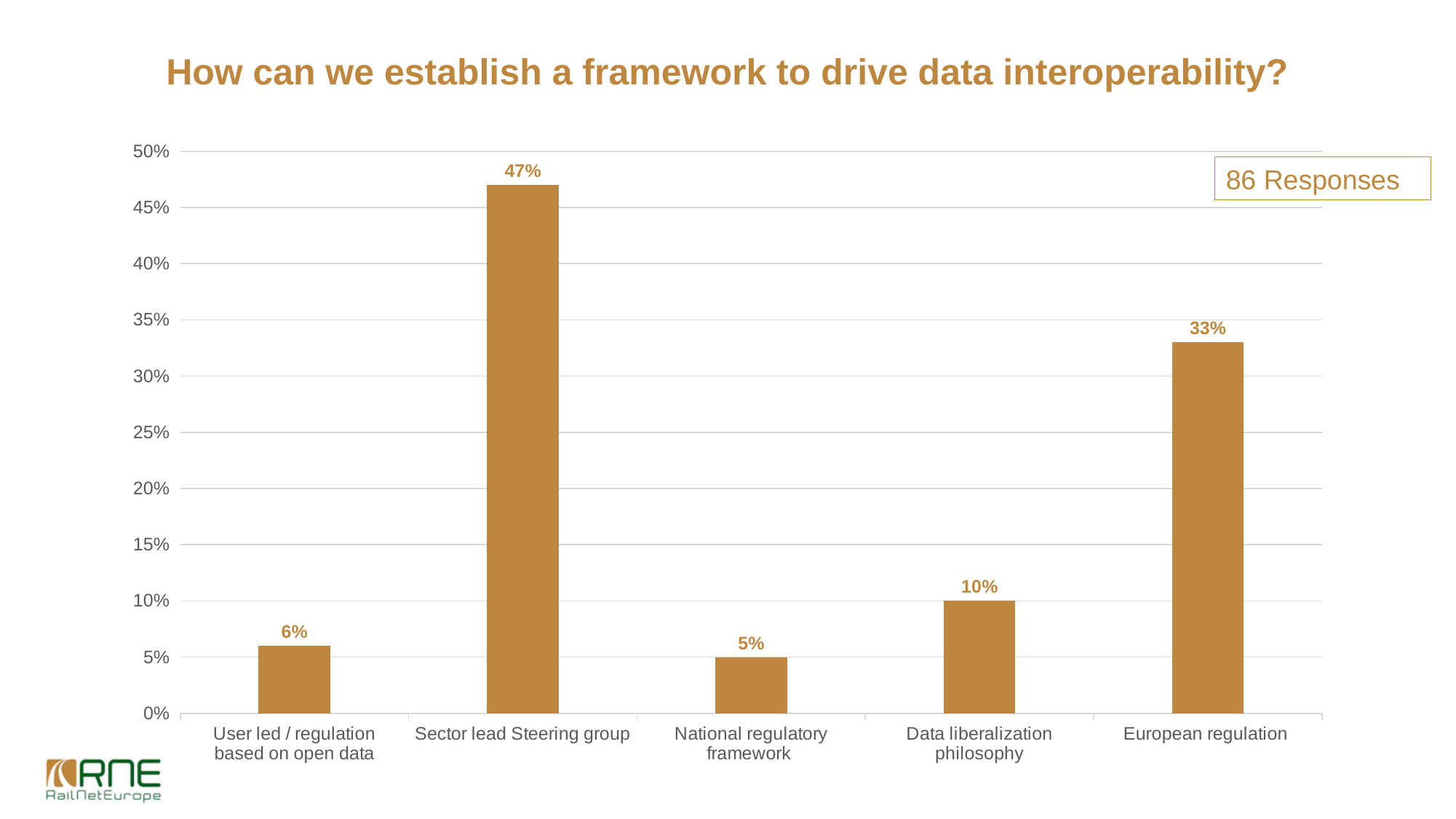
Which category has the highest value? Sector lead Steering group Which category has the lowest value? National regulatory framework What is the value for 'Data liberalization philosophy'? 10% What percentage of responses chose 'Sector lead Steering group'? 47% What is the value for 'National regulatory framework'? 5% How many responses does the chart report? 86 Responses Is the value for 'European regulation' greater or less than 30%? greater What is the value for 'European regulation'? 33% Which is larger: 'User led / regulation based on open data' or 'Data liberalization philosophy'? Data liberalization philosophy What kind of chart is shown on the slide? Bar chart How many categories are shown on the chart? 5 What is the difference between 'Sector lead Steering group' and 'European regulation'? 14%